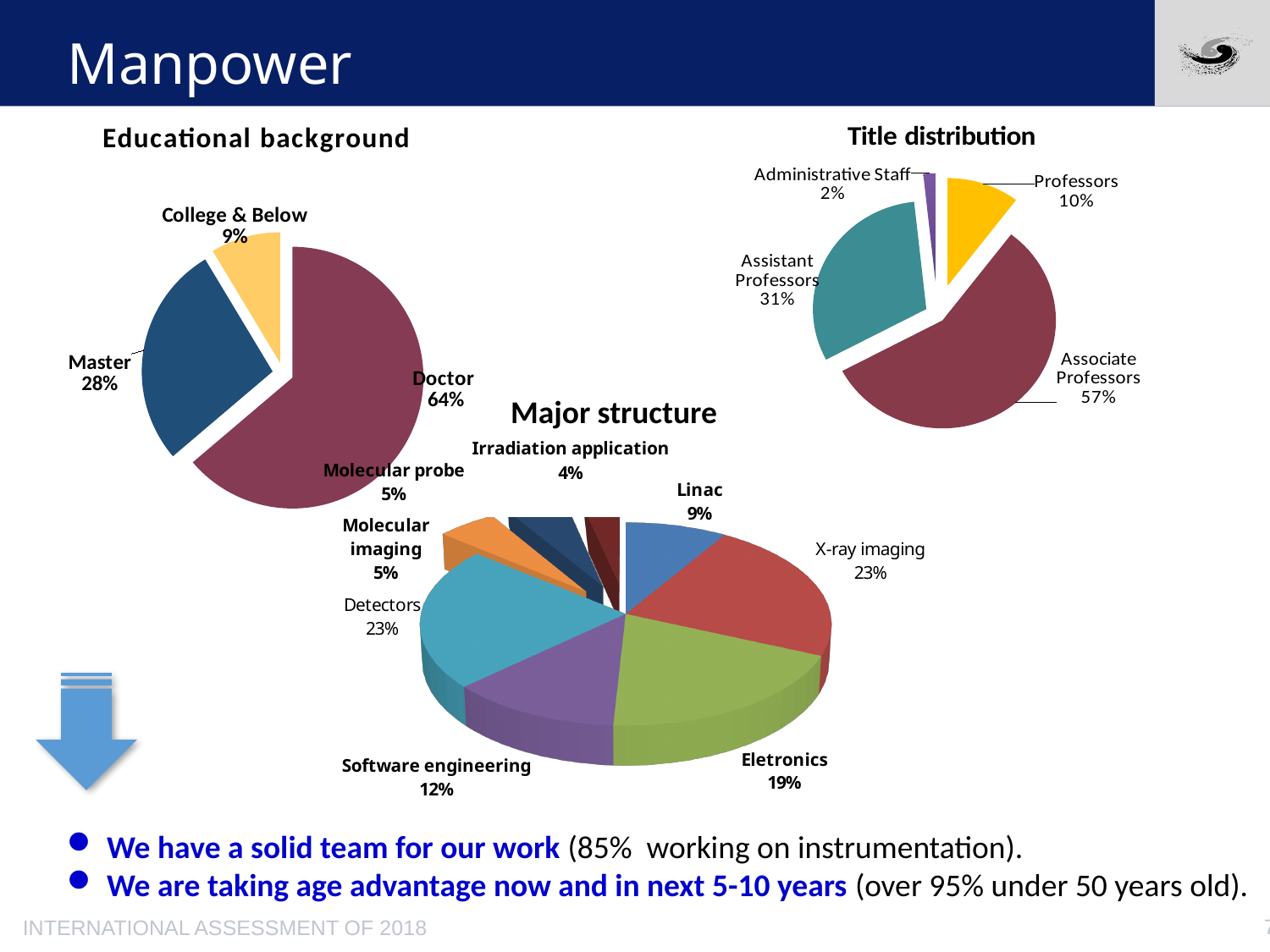
In the Educational background chart, which category has the smallest share? College & Below How many categories does the Major structure chart show? 8 In the Title distribution chart, which category has the smallest share? Administrative Staff In the Major structure chart, what is the value for Software engineering? 12% In the Title distribution chart, which category has the largest share? Associate Professors In the Educational background chart, what share of the pie is Doctor? 64% In the Major structure chart, which is larger, Eletronics or Linac? Eletronics In the Title distribution chart, what is the value for Assistant Professors? 31% In the Educational background chart, what is the value for Master? 28% What kind of chart is the Major structure chart? Pie chart In the Educational background chart, what is the difference between Doctor and Master? 36% How many categories does the Title distribution chart show? 4